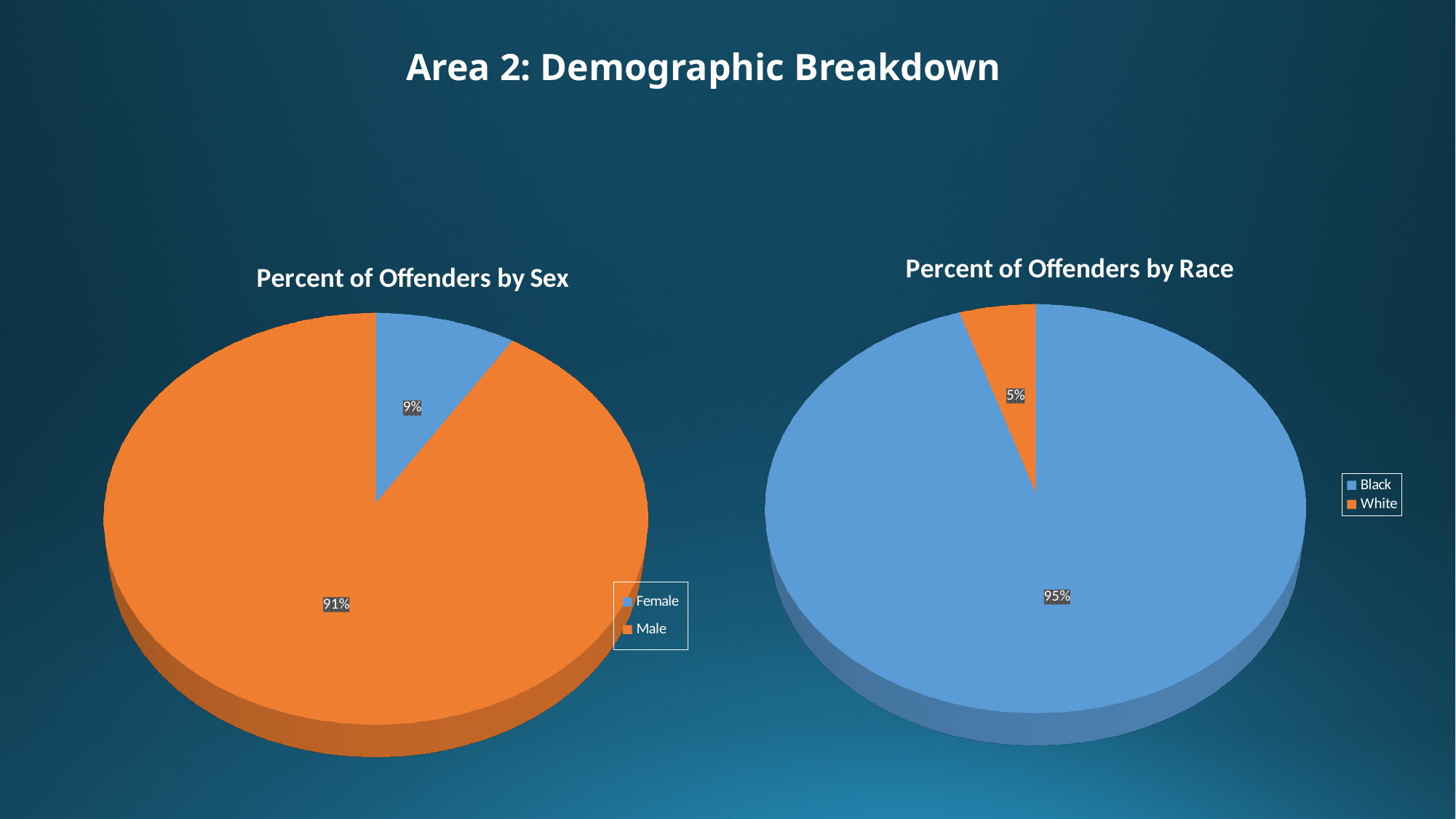
In the 'Percent of Offenders by Sex' chart, what is the difference in percentage points between Male and Female? 82 In the 'Percent of Offenders by Sex' chart, what percentage of offenders are Male? 91% How many categories does the 'Percent of Offenders by Sex' chart show? 2 In the 'Percent of Offenders by Sex' chart, what percentage of offenders are Female? 9% In the 'Percent of Offenders by Race' chart, what is the difference in percentage points between Black and White? 90 In the 'Percent of Offenders by Race' chart, what percentage of offenders are White? 5% In the 'Percent of Offenders by Sex' chart, what colour is the Female slice? Blue What kind of chart is the 'Percent of Offenders by Race' chart? Pie chart In the 'Percent of Offenders by Race' chart, which category has the smallest slice? White In the 'Percent of Offenders by Race' chart, which is larger, the Black slice or the White slice? Black In the 'Percent of Offenders by Race' chart, what percentage of offenders are Black? 95% In the 'Percent of Offenders by Sex' chart, which category has the largest slice? Male